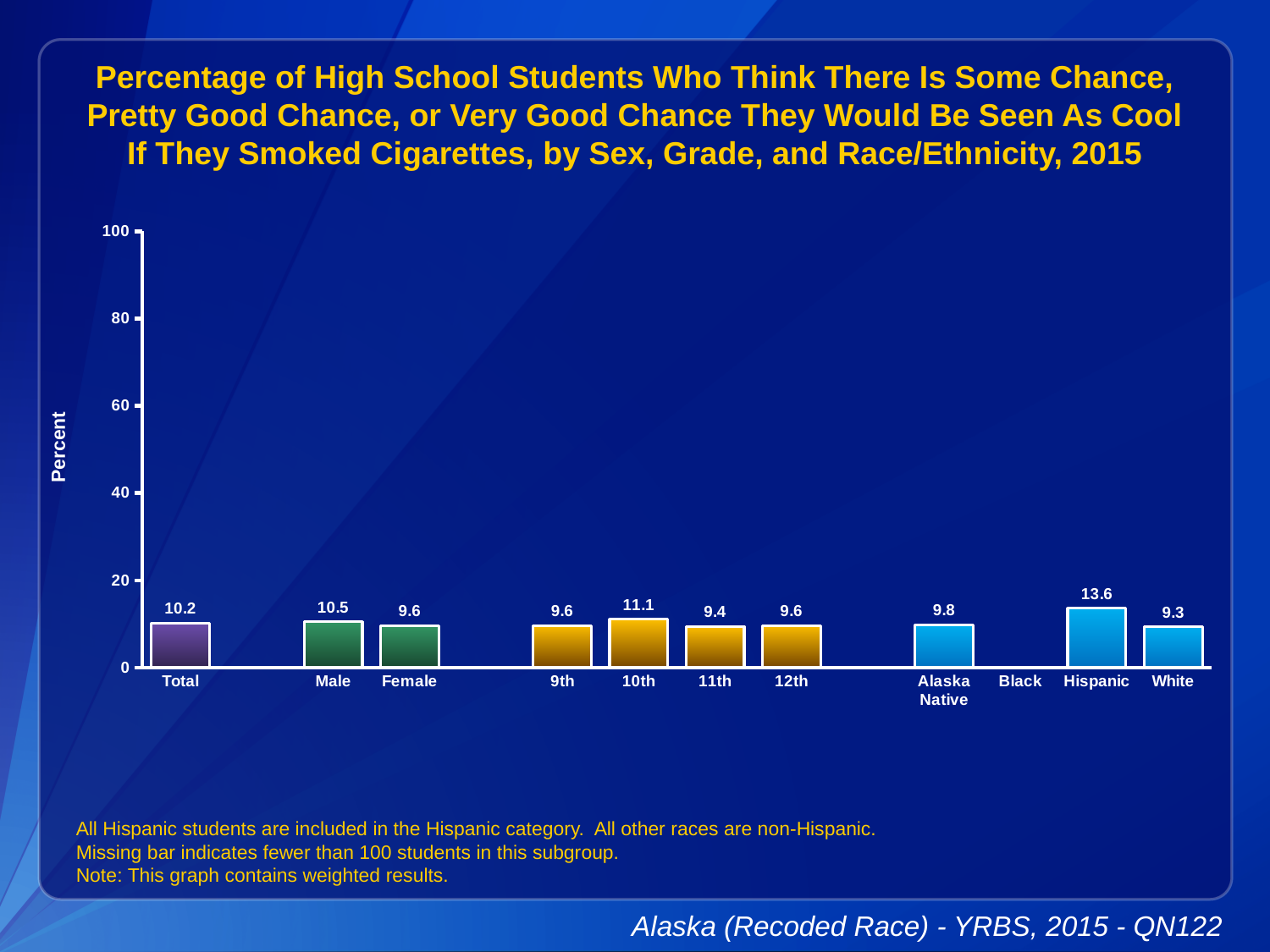
Which category has the lowest value among the bars shown? White What is the value for 10th grade? 11.1 What kind of chart is shown on the slide? bar chart What is the value for Total? 10.2 Which category label has no bar plotted? Black How many bars are plotted on the chart? 11 Which is larger, the value for 10th grade or the value for 11th grade? 10th What is the value for Hispanic? 13.6 Is the value for Hispanic greater or less than 20? less What is the difference between the Male and Female values? 0.9 Which category has the highest value? Hispanic What is the value for Male? 10.5